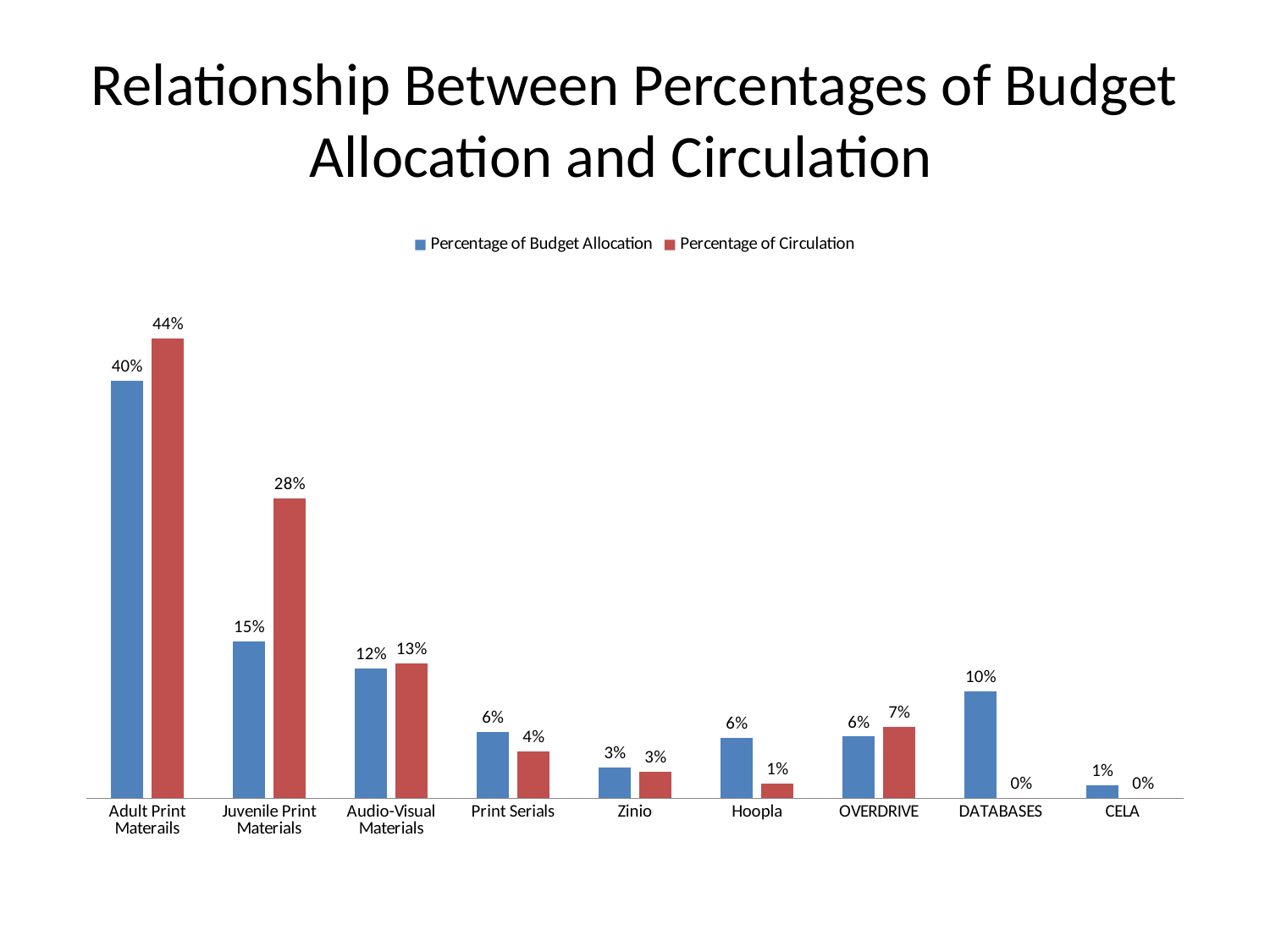
What is the Percentage of Budget Allocation for DATABASES? 10% Which category has the highest Percentage of Circulation? Adult Print Materails What is the difference between the Percentage of Budget Allocation and the Percentage of Circulation for Juvenile Print Materials? 13% Which category has the lowest Percentage of Budget Allocation? CELA What kind of chart is shown on the slide? Bar chart What is the Percentage of Circulation for Hoopla? 1% What is the difference between the Percentage of Circulation and the Percentage of Budget Allocation for Adult Print Materails? 4% How many categories are shown on the x axis? 9 How many series does the legend list? 2 What is the Percentage of Circulation for Juvenile Print Materials? 28% Which is larger for Print Serials: the Percentage of Budget Allocation or the Percentage of Circulation? Percentage of Budget Allocation What is the Percentage of Budget Allocation for Adult Print Materails? 40%